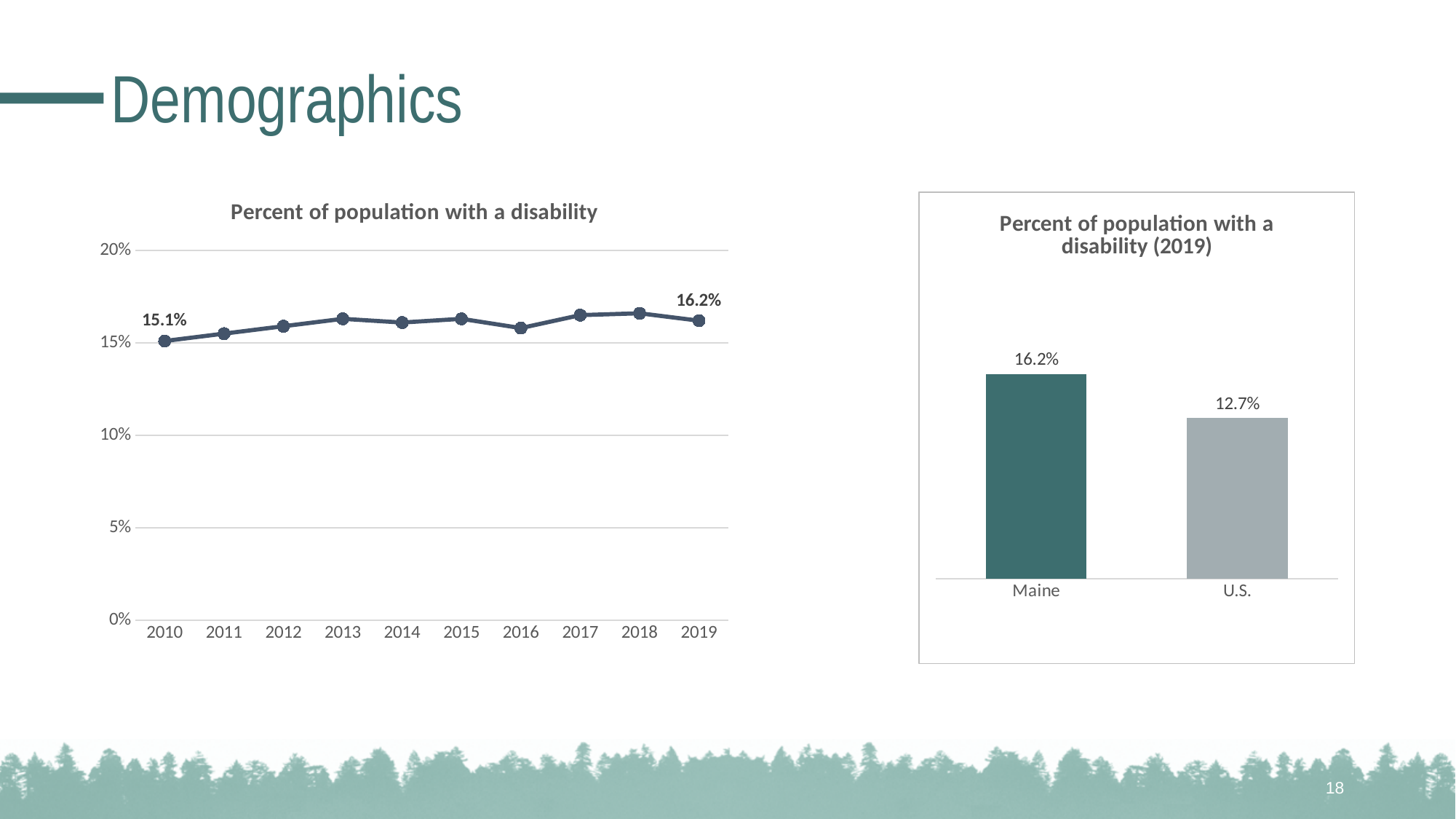
In the chart 'Percent of population with a disability (2019)', what is the value for U.S.? 12.7% In the chart 'Percent of population with a disability (2019)', what is the difference between the Maine value and the U.S. value? 3.5% In the line chart 'Percent of population with a disability', what is the difference between the 2019 value and the 2010 value? 1.1% What kind of chart is the chart on the left of the slide? line chart In the line chart 'Percent of population with a disability', what is the value for 2019? 16.2% In the line chart 'Percent of population with a disability', is the value for 2015 greater or less than 15%? greater In the chart 'Percent of population with a disability (2019)', what is the value for Maine? 16.2% In the chart 'Percent of population with a disability (2019)', which category has the higher value, Maine or U.S.? Maine In the line chart 'Percent of population with a disability', how many years are plotted on the x axis? 10 In the line chart 'Percent of population with a disability', is the value for 2013 greater or less than 20%? less In the line chart 'Percent of population with a disability', what is the value for 2010? 15.1% In the line chart 'Percent of population with a disability', do the values generally rise or fall from 2010 to 2019? rise